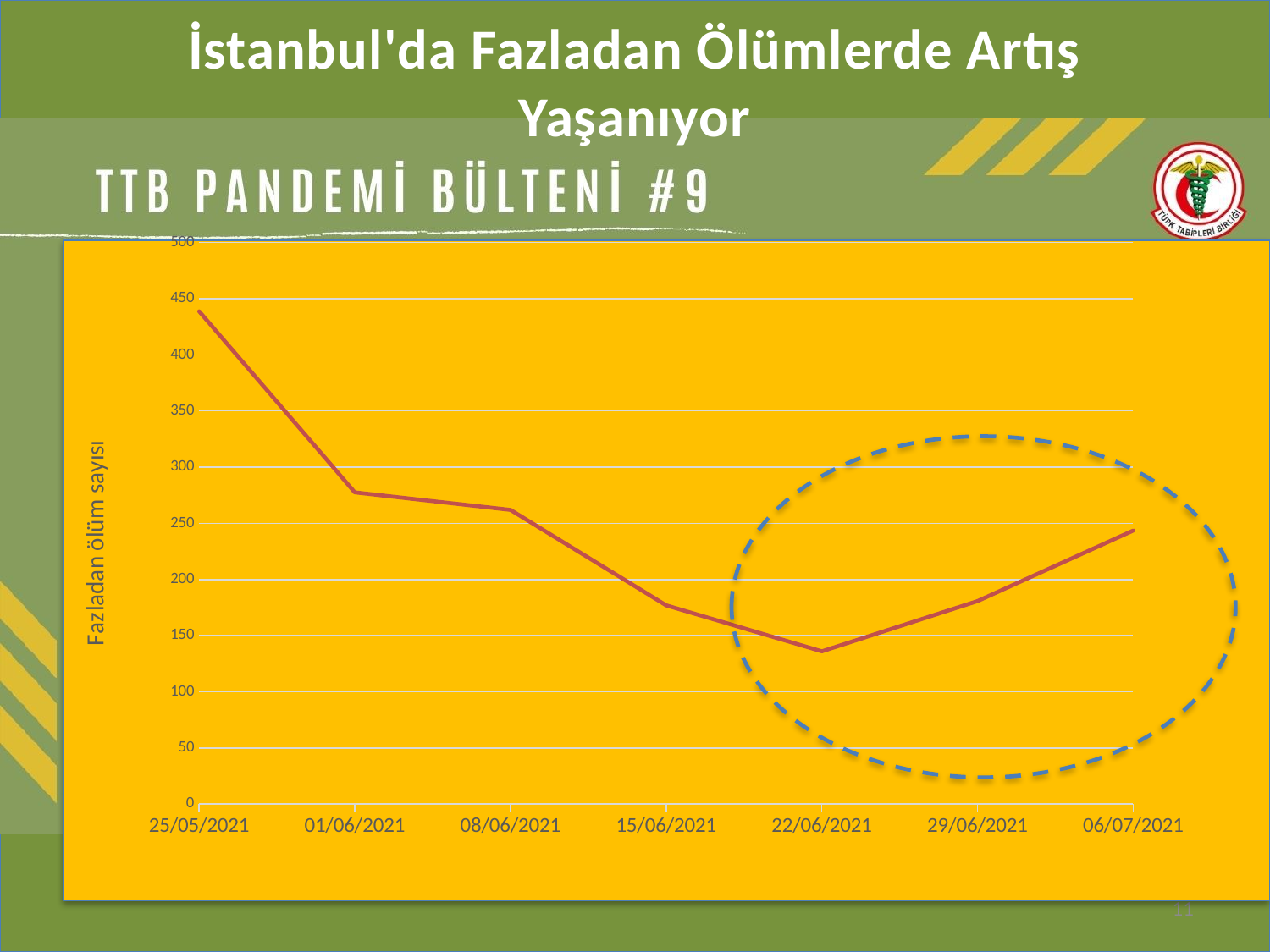
Is the value for 25/05/2021 greater or less than 400? greater Is the value for 22/06/2021 greater or less than 150? less What is the label on the vertical axis of the chart? Fazladan ölüm sayısı On which date is the excess death count highest? 25/05/2021 Do the values rise or fall from 22/06/2021 to 06/07/2021? rise Do the values rise or fall from 25/05/2021 to 22/06/2021? fall Is the value for 06/07/2021 greater or less than 200? greater On which date is the excess death count lowest? 22/06/2021 How many dates are plotted along the x axis of the chart? 7 Which date has the larger value, 15/06/2021 or 06/07/2021? 06/07/2021 What kind of chart is shown on the slide? line chart